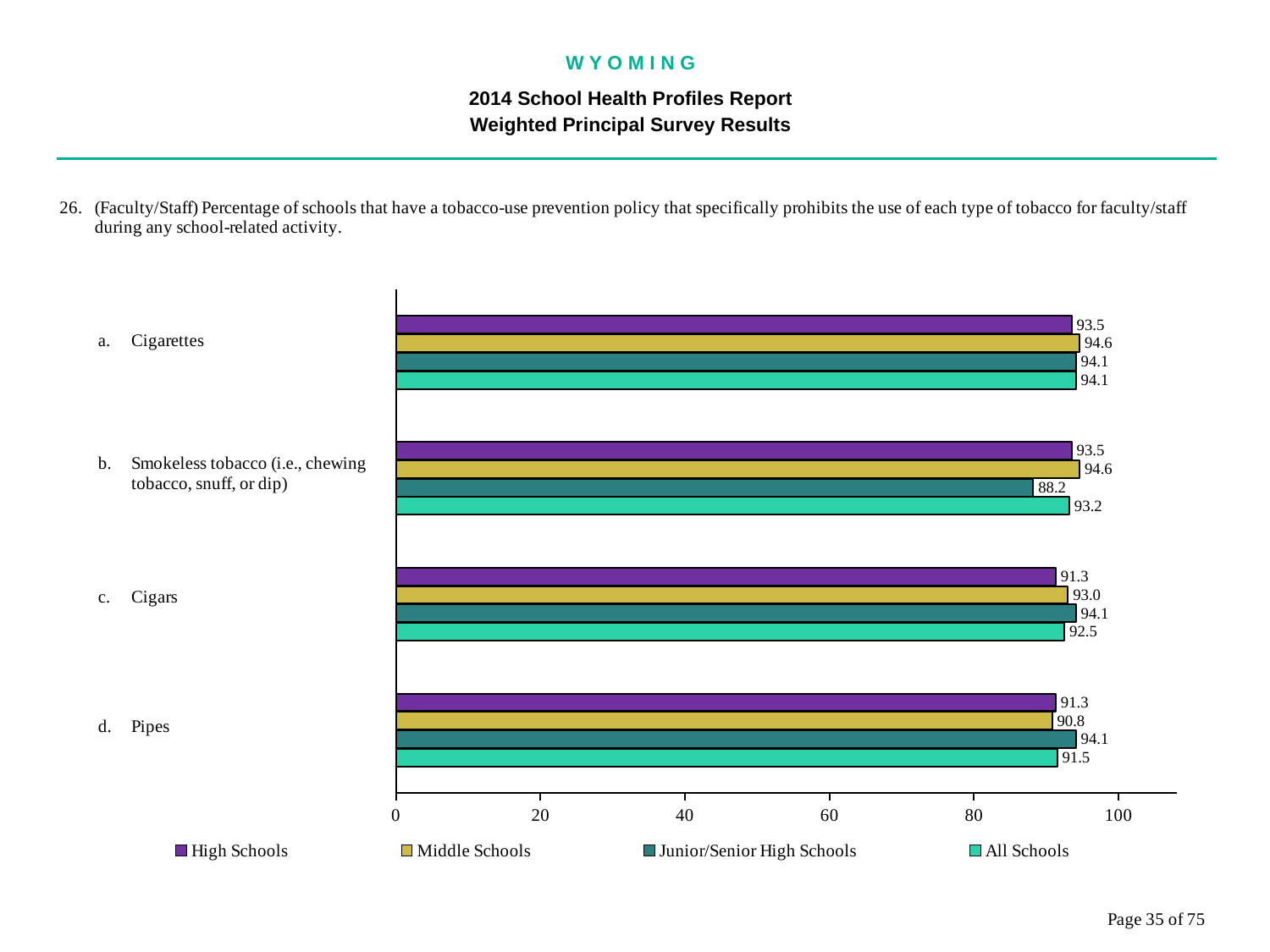
Which is larger for Pipes: the High Schools value or the Junior/Senior High Schools value? Junior/Senior High Schools What is the value for High Schools for Cigars? 91.3 How many series does the legend list? 4 What is the value for Middle Schools for Cigarettes? 94.6 Which series is shown in purple in the legend? High Schools What is the value for Junior/Senior High Schools for Smokeless tobacco? 88.2 How many tobacco categories are shown on the chart? 4 What is the value for All Schools for Pipes? 91.5 What is the difference between the Middle Schools and Junior/Senior High Schools values for Smokeless tobacco? 6.4 Which series has the highest value for Cigars? Junior/Senior High Schools Which series has the lowest value for Pipes? Middle Schools What kind of chart is shown on the slide? bar chart